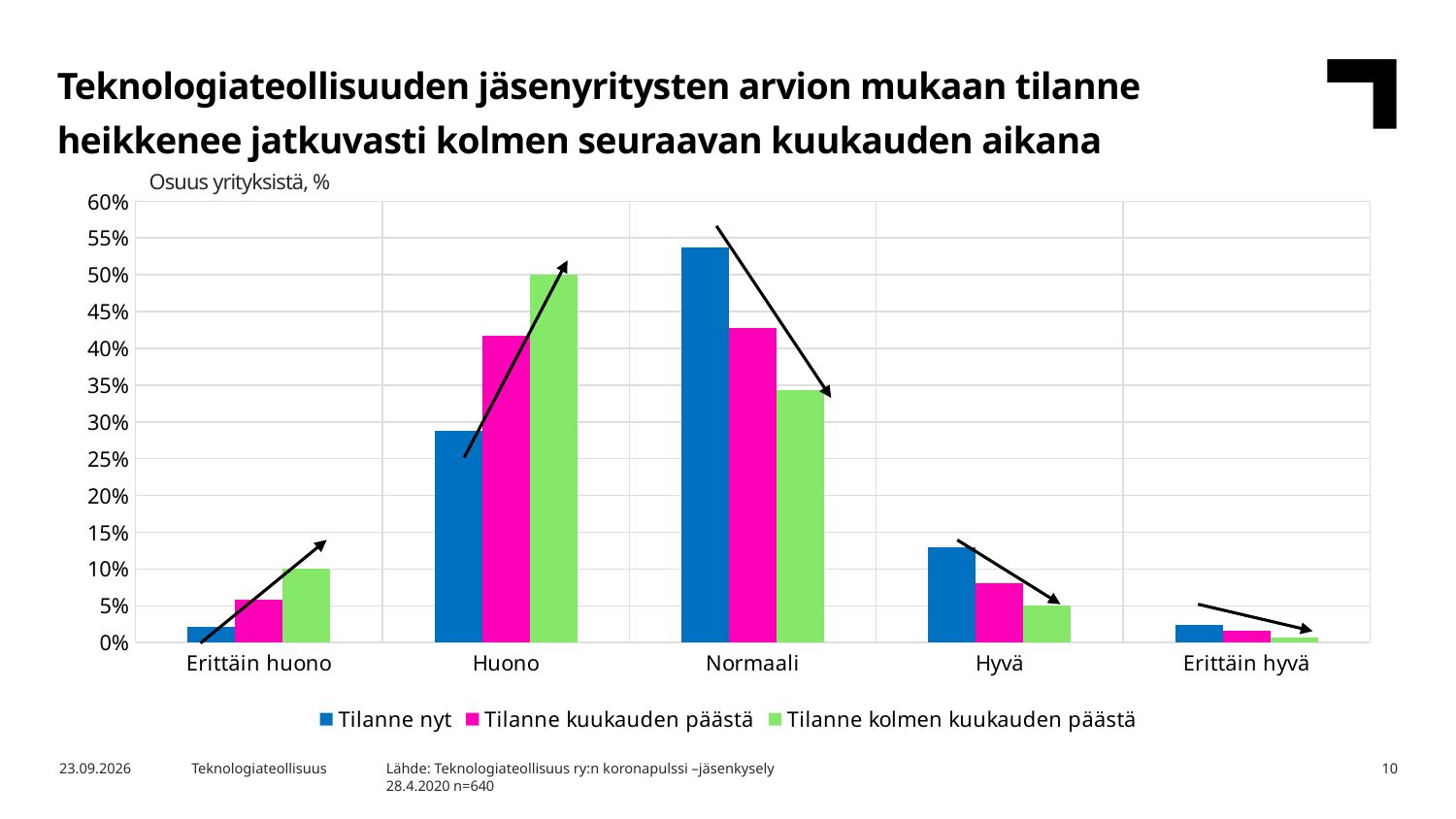
Which category has the highest value for the series Tilanne nyt? Normaali Is the value for Normaali in the series Tilanne kolmen kuukauden päästä greater or less than 40%? less What kind of chart is shown on the slide? bar chart For the category Huono, which is larger: the value for Tilanne nyt or for Tilanne kolmen kuukauden päästä? Tilanne kolmen kuukauden päästä What is the value for Huono in the series Tilanne kolmen kuukauden päästä? 50% What label is shown above the y axis of the chart? Osuus yrityksistä, % For the category Normaali, do the values rise or fall from Tilanne nyt to Tilanne kolmen kuukauden päästä? fall How many series does the legend list? 3 Is the value for Huono in the series Tilanne kuukauden päästä greater or less than 40%? greater Which category has the lowest value for the series Tilanne kolmen kuukauden päästä? Erittäin hyvä How many categories are shown on the x axis? 5 Is the value for Normaali in the series Tilanne nyt greater or less than 50%? greater